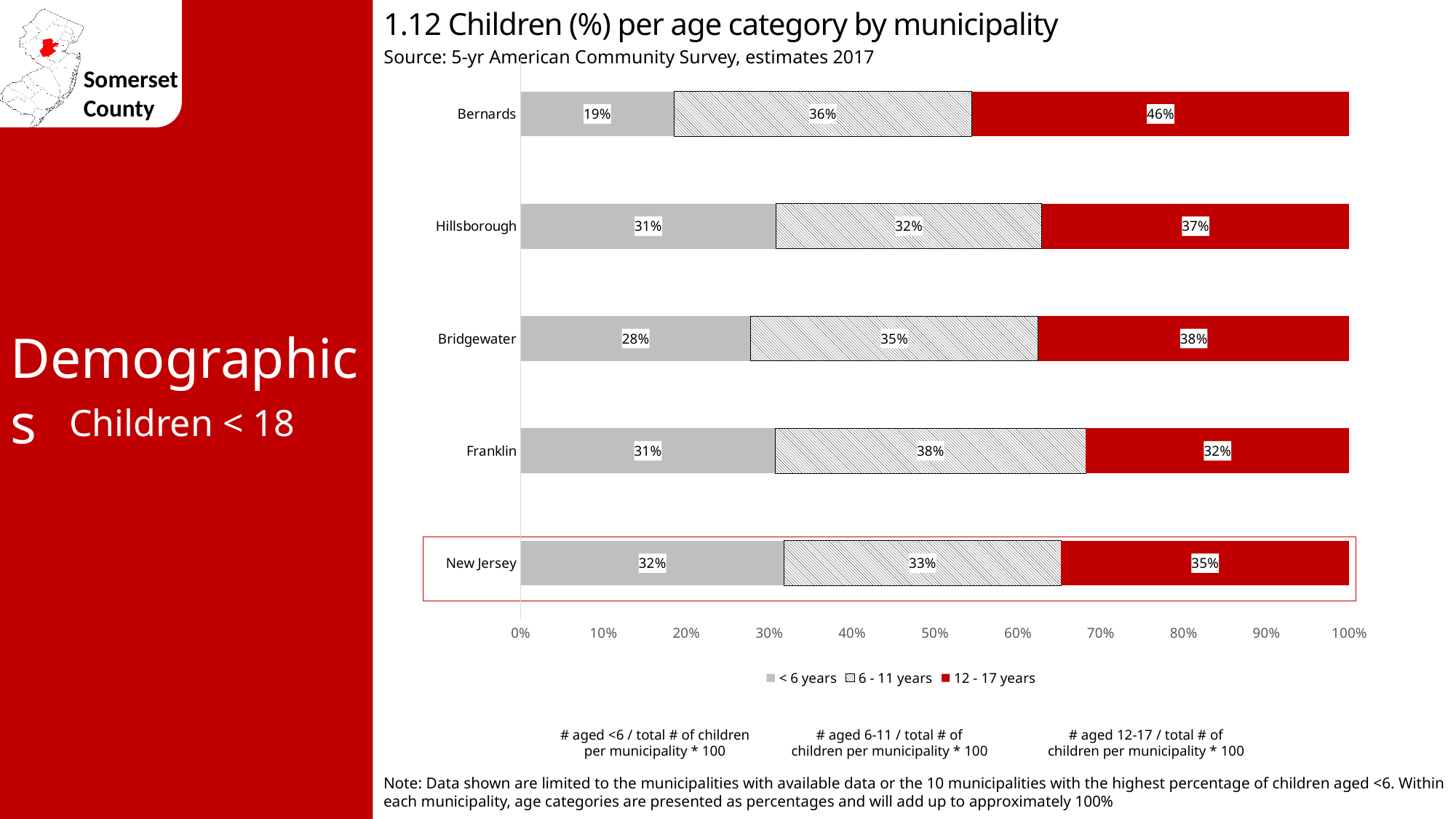
Which municipality has the highest percentage of children aged 12 - 17 years? Bernards What percentage of children in New Jersey are aged 6 - 11 years? 33% What is the value for the 6 - 11 years category in Franklin? 38% How many series does the legend list? 3 What percentage of children in Hillsborough are under 6 years old? 31% What is the source of the data shown in the chart? 5-yr American Community Survey, estimates 2017 What percentage of children in Bernards are aged 12 - 17 years? 46% What is the difference between the 12 - 17 years percentage for Bernards and for Franklin? 14% Which is larger: the < 6 years value for Bridgewater or for New Jersey? New Jersey What kind of chart is shown on the slide? Stacked bar chart How many municipalities or regions are shown on the chart? 5 Which municipality has the lowest percentage of children under 6 years? Bernards